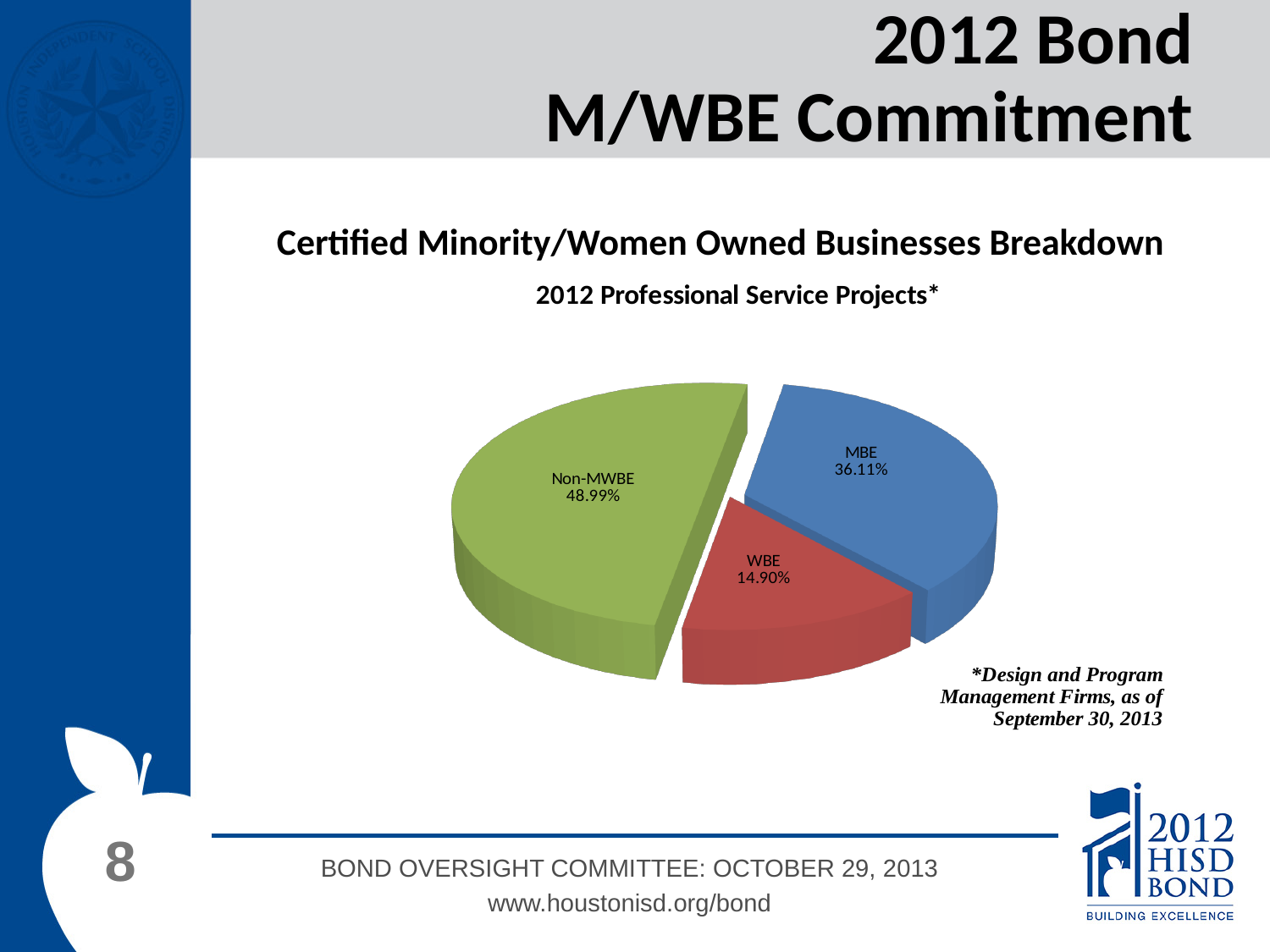
Which slice is larger, MBE or WBE? MBE Which category has the smallest slice of the pie? WBE What kind of chart is shown on the slide? Pie chart What share of the pie does MBE represent? 36.11% What is the title of the chart? 2012 Professional Service Projects* What share of the pie does Non-MWBE represent? 48.99% What share of the pie does WBE represent? 14.90% What is the difference in percentage points between the MBE and WBE slices? 21.21 Which category has the largest slice of the pie? Non-MWBE How many slices does the pie chart have? 3 What is the difference in percentage points between the Non-MWBE and MBE slices? 12.88 What colour is the WBE slice? Red